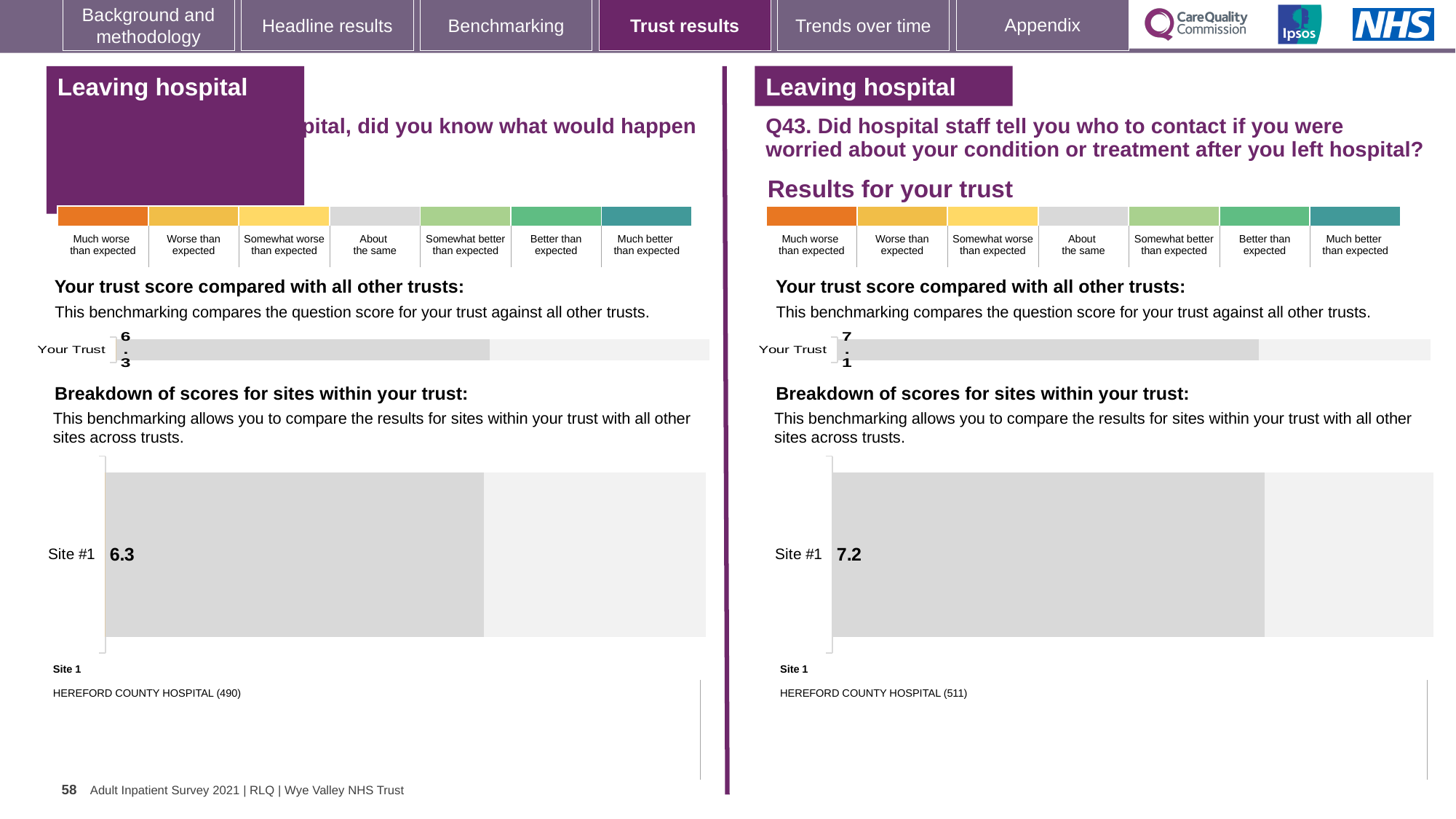
On the right half of the slide (Q43), what is the difference between the Site #1 score and the 'Your Trust' score? 0.1 What is the difference between the Site #1 score on the right half of the slide (Q43) and the Site #1 score on the left half? 0.9 How many sites are shown in the breakdown of scores for sites chart on the right half of the slide (Q43)? 1 On the left half of the slide, which site is listed as Site 1 below the breakdown chart? HEREFORD COUNTY HOSPITAL (490) On the right half of the slide (Q43), what is the score shown for 'Your Trust' in the trust score chart? 7.1 On the left half of the slide, what is the score shown for 'Your Trust' in the trust score chart? 6.3 On the left half of the slide, what is the score shown for Site #1 in the breakdown of scores for sites chart? 6.3 Is the 'Your Trust' score on the left half of the slide greater or less than the 'Your Trust' score on the right half (Q43)? less On the right half of the slide (Q43), what is the score shown for Site #1 in the breakdown of scores for sites chart? 7.2 Which is larger: the Site #1 score on the left half of the slide or the Site #1 score on the right half (Q43)? Right half (Q43), 7.2 On the right half of the slide (Q43), which site is listed as Site 1 below the breakdown chart? HEREFORD COUNTY HOSPITAL (511) What type of chart is used to show the Site #1 score on the left half of the slide? Bar chart